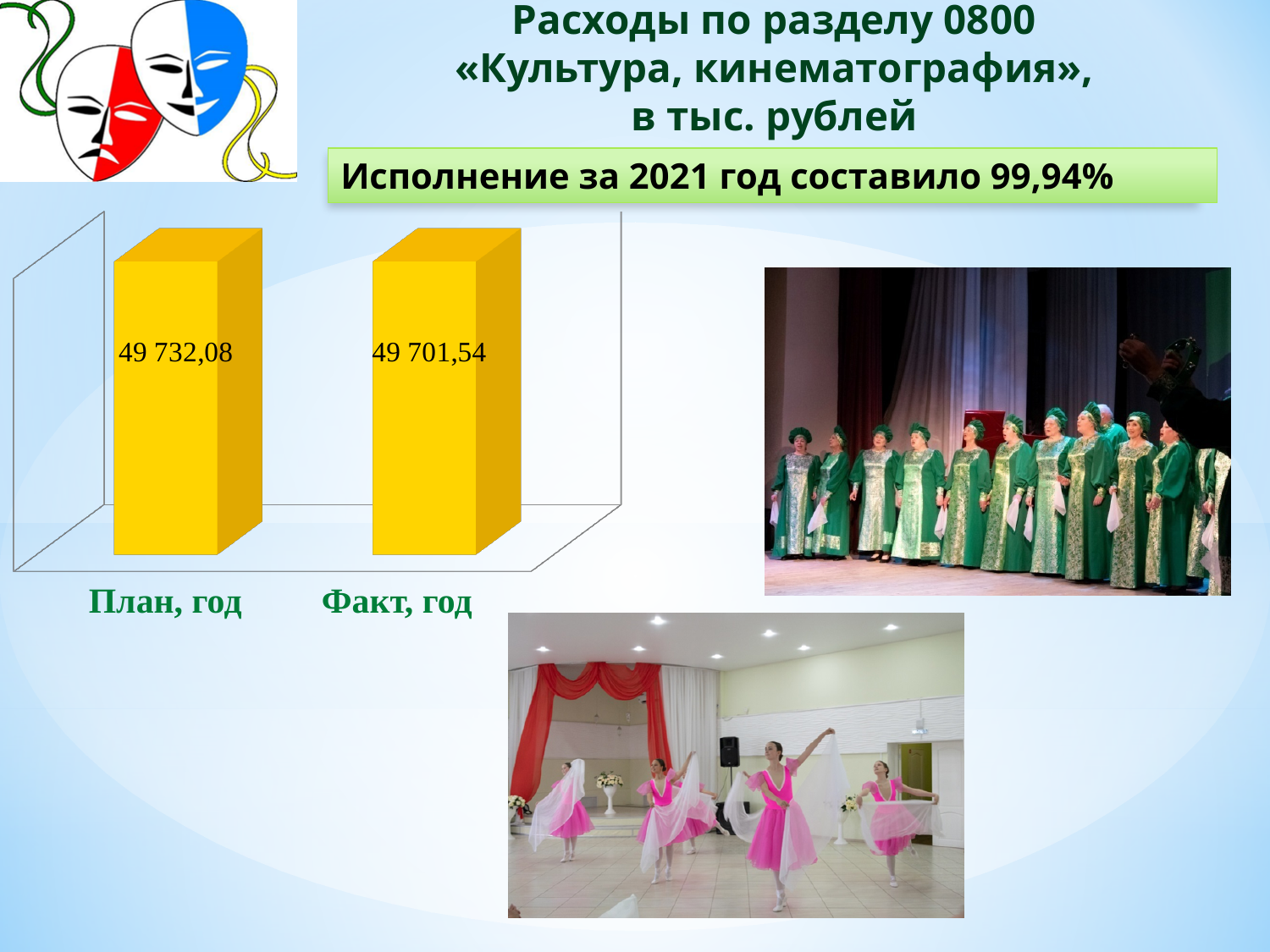
Is the value for Факт, год greater or less than 49 732,08? less What type of chart is shown on the slide? Bar chart What colour are the bars on the chart? Yellow According to the slide, what was the execution percentage for 2021? 99,94% What is the value of the Факт, год bar? 49 701,54 What is the difference between the План, год and Факт, год values? 30,54 Which category has the lowest value on the chart? Факт, год How many bars are shown on the chart? 2 Which bar has the higher value, План, год or Факт, год? План, год What is the value of the План, год bar? 49 732,08 Which category has the highest value on the chart? План, год